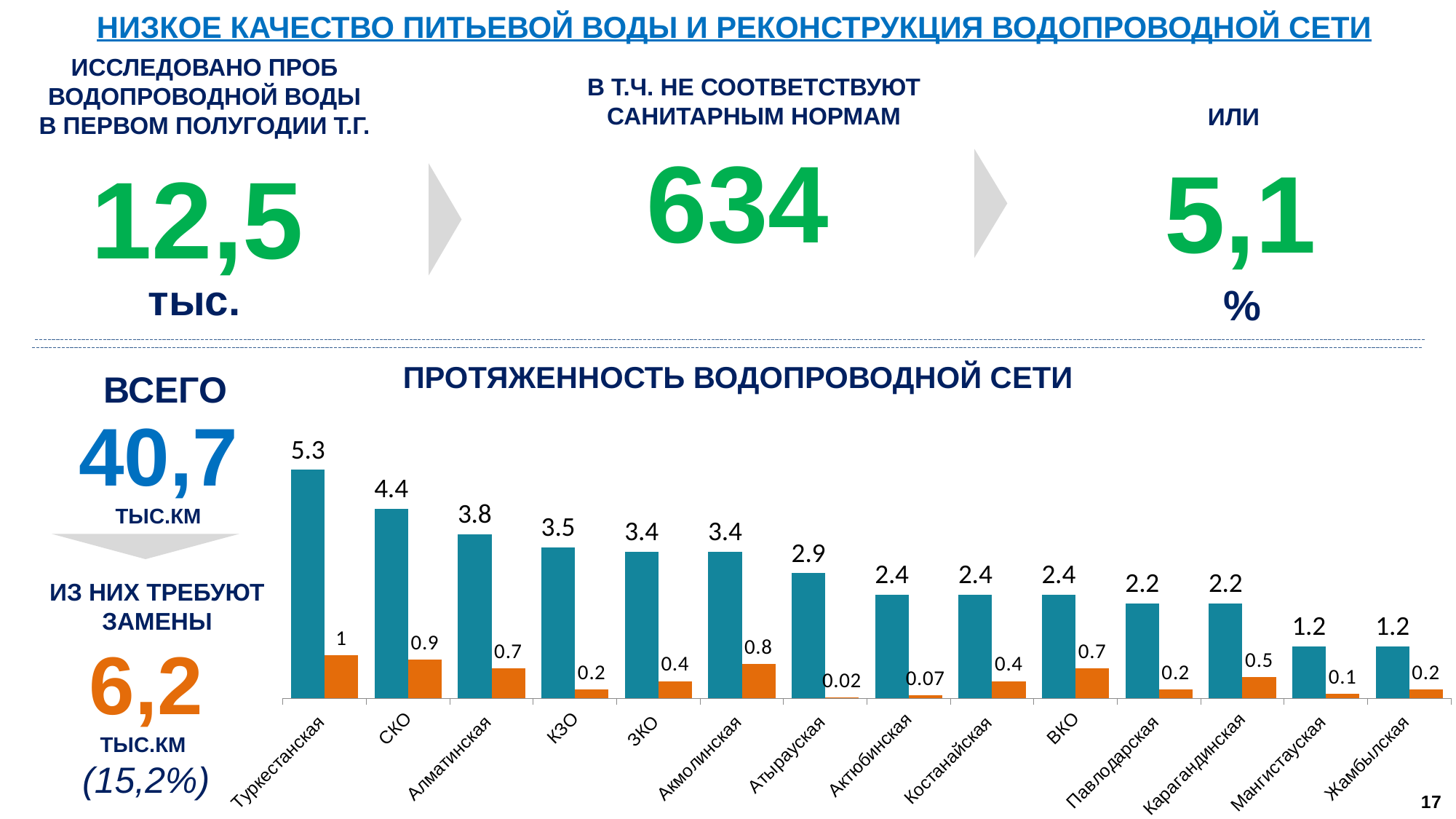
What is the value of the orange bar for Акмолинская? 0.8 What is the difference between the blue bar values for Туркестанская and СКО? 0.9 What is the value of the blue bar for Туркестанская? 5.3 What is the difference between the orange bar values for ВКО and Костанайская? 0.3 What is the value of the blue bar for Карагандинская? 2.2 How many categories are shown on the x axis of the chart? 14 What is the value of the orange bar for Атырауская? 0.02 Which category has the highest blue bar? Туркестанская What type of chart is shown on the slide? bar chart Which has a larger blue bar, Алматинская or Атырауская? Алматинская Which category has the lowest orange bar? Атырауская What is the title of the chart? ПРОТЯЖЕННОСТЬ ВОДОПРОВОДНОЙ СЕТИ